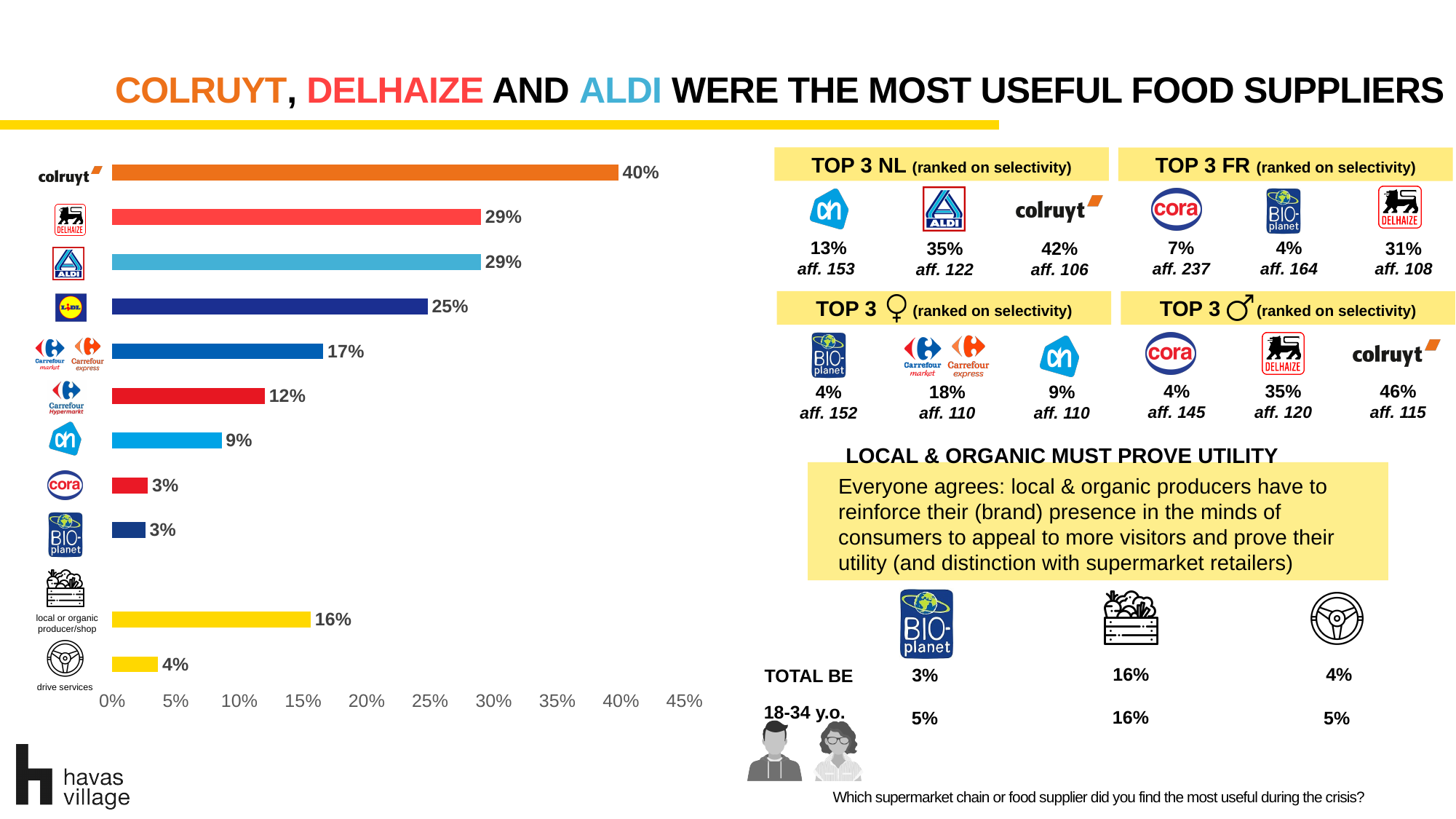
What is the highest tick label shown on the x axis of the bar chart? 45% Which supplier has the highest value in the bar chart? Colruyt What percentage is shown for Cora in the bar chart? 3% What percentage is shown for Colruyt in the bar chart? 40% What is the difference between the Colruyt value and the Delhaize value in the bar chart? 11 percentage points What kind of chart is shown on the left of the slide? bar chart What percentage is shown for Lidl in the bar chart? 25% What percentage is shown for 'local or organic producer/shop' in the bar chart? 16% Which has a larger value in the bar chart, Lidl or 'local or organic producer/shop'? Lidl What is the difference between the Lidl value and the Carrefour Hypermarkt value in the bar chart? 13 percentage points What percentage is shown for 'drive services' in the bar chart? 4% How many bars are plotted in the bar chart? 11